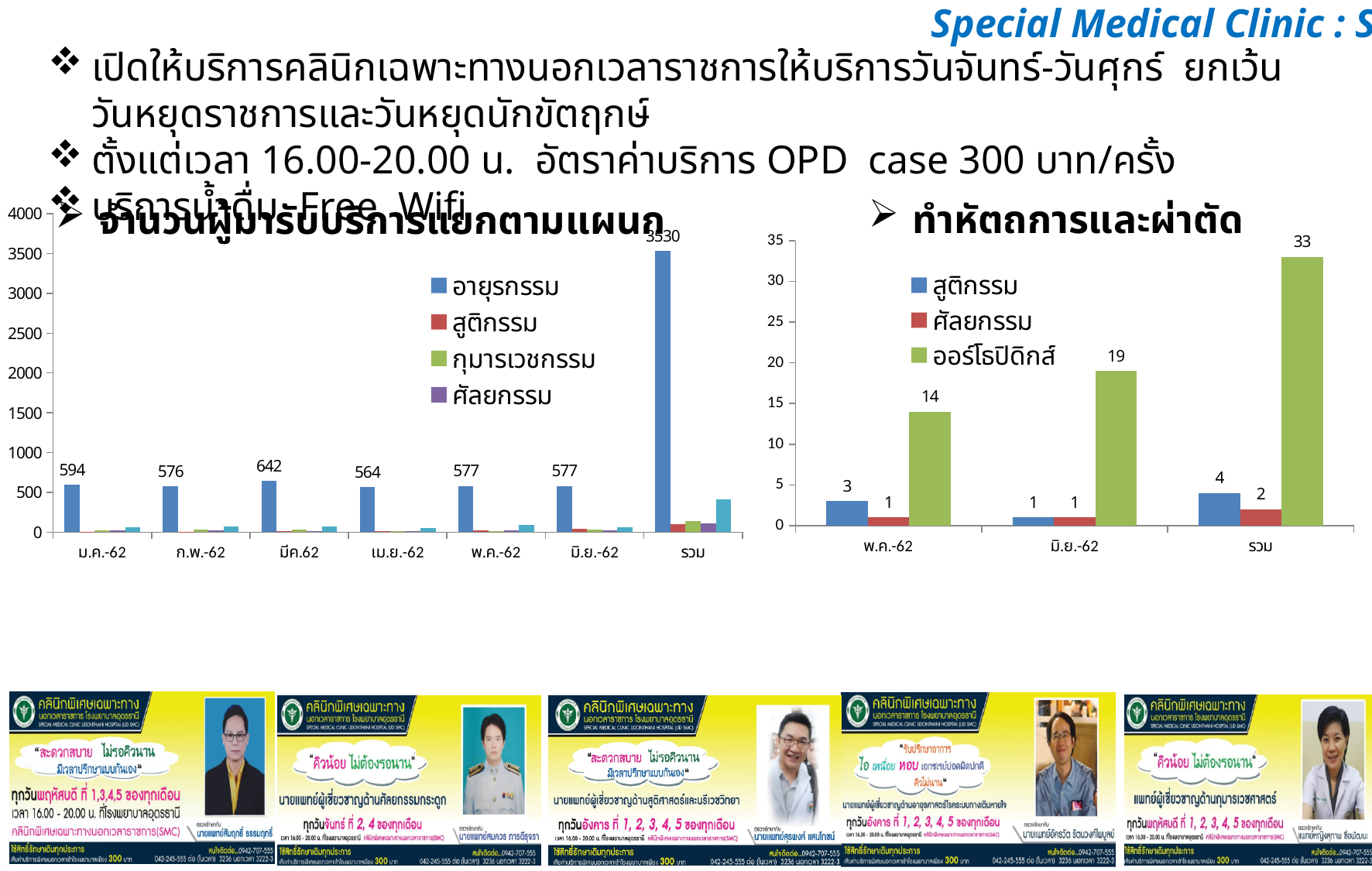
In the chart titled ทำหัตถการและผ่าตัด, what is the difference between the ออร์โธปิดิกส์ and สูติกรรม values in the รวม category? 29 What kind of chart is the chart titled ทำหัตถการและผ่าตัด? bar chart In the chart titled จำนวนผู้มารับบริการแยกตามแผนก, what is the value for อายุรกรรม in มีค.62? 642 In the chart titled จำนวนผู้มารับบริการแยกตามแผนก, what is the difference between the อายุรกรรม values for มีค.62 and เม.ย.-62? 78 In the chart titled จำนวนผู้มารับบริการแยกตามแผนก, which month (excluding รวม) has the highest value for อายุรกรรม? มีค.62 How many series does the legend list in the chart titled จำนวนผู้มารับบริการแยกตามแผนก? 4 In the chart titled ทำหัตถการและผ่าตัด, what is the value for ออร์โธปิดิกส์ in มิ.ย.-62? 19 How many categories are shown on the x axis of the chart titled จำนวนผู้มารับบริการแยกตามแผนก? 7 In the chart titled ทำหัตถการและผ่าตัด, does the value for ออร์โธปิดิกส์ rise or fall from พ.ค.-62 to มิ.ย.-62? rise In the chart titled ทำหัตถการและผ่าตัด, which is larger for สูติกรรม: พ.ค.-62 or มิ.ย.-62? พ.ค.-62 In the chart titled จำนวนผู้มารับบริการแยกตามแผนก, which month (excluding รวม) has the lowest value for อายุรกรรม? เม.ย.-62 In the chart titled จำนวนผู้มารับบริการแยกตามแผนก, what is the value for อายุรกรรม in the รวม category? 3530